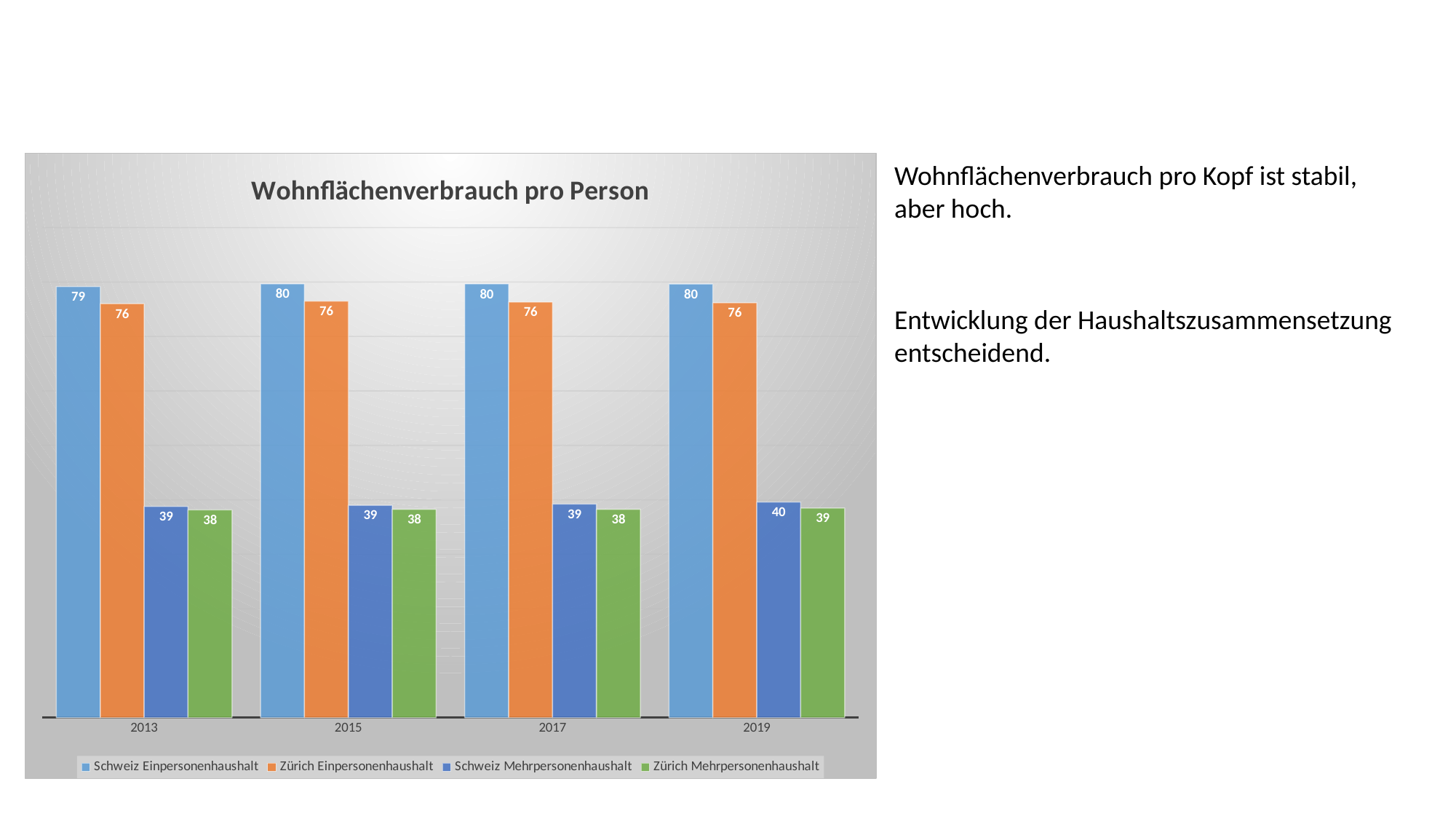
Which series has the lowest value in 2013? Zürich Mehrpersonenhaushalt What is the title of the chart? Wohnflächenverbrauch pro Person What is the value for Zürich Mehrpersonenhaushalt in 2015? 38 How many years are shown on the x axis? 4 What is the value for Zürich Einpersonenhaushalt in 2017? 76 What is the value for Schweiz Einpersonenhaushalt in 2013? 79 Which is larger in 2019: Schweiz Mehrpersonenhaushalt or Zürich Mehrpersonenhaushalt? Schweiz Mehrpersonenhaushalt How many series does the legend list? 4 What kind of chart is shown on the slide? Bar chart What is the difference between Schweiz Einpersonenhaushalt and Zürich Einpersonenhaushalt in 2015? 4 What is the value for Schweiz Mehrpersonenhaushalt in 2019? 40 Which series has the highest value in 2019? Schweiz Einpersonenhaushalt